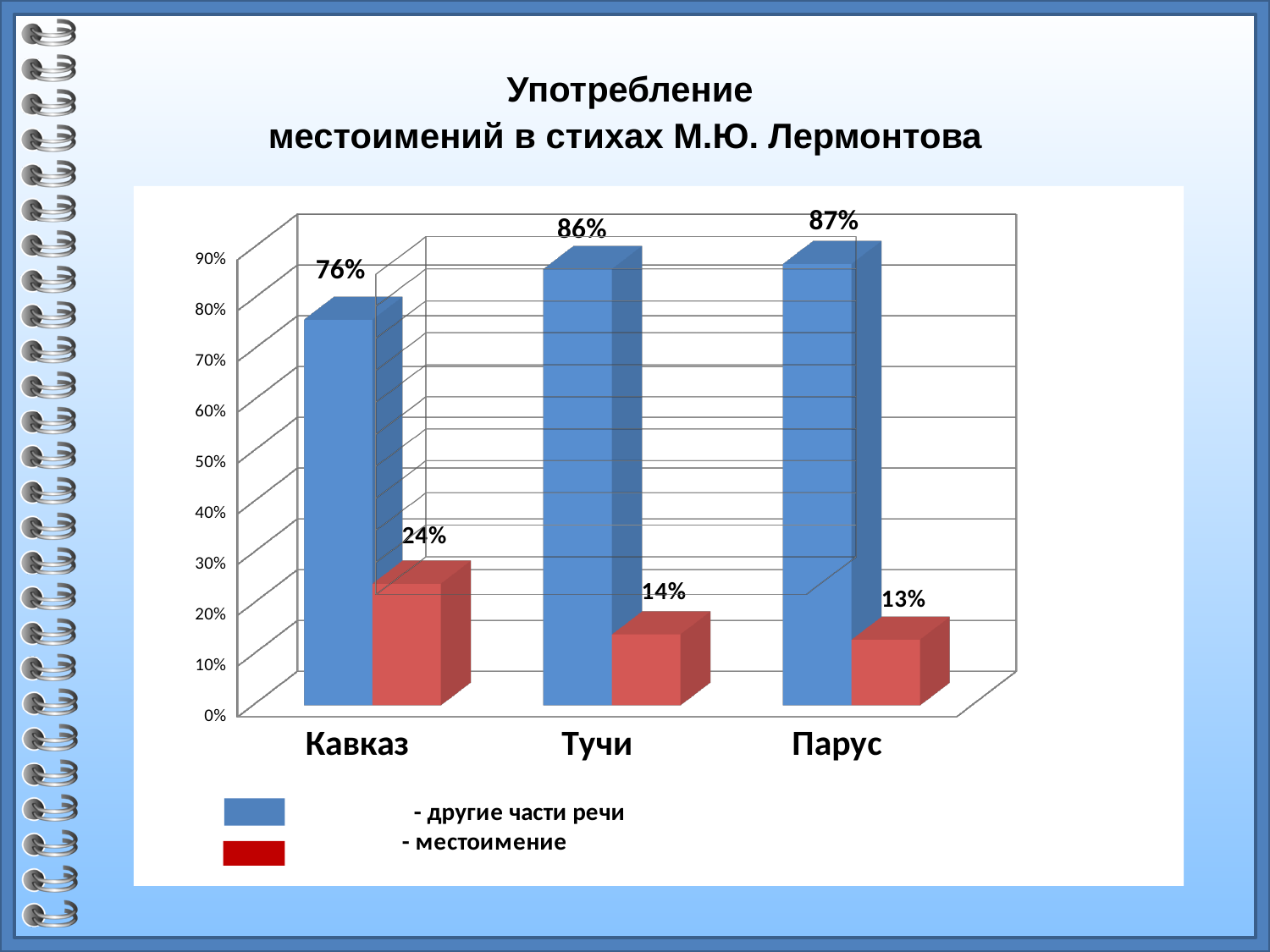
How many poems (categories) are shown on the x axis? 3 Which poem has the lowest value for 'местоимение'? Парус What is the value for 'местоимение' in 'Парус'? 13% What kind of chart is shown on the slide? bar chart Which colour represents 'местоимение' in the legend? red How many series does the legend list? 2 Do the 'местоимение' values rise or fall from 'Кавказ' to 'Парус'? fall What is the value for 'другие части речи' in 'Кавказ'? 76% What is the difference between the 'местоимение' values for 'Кавказ' and 'Тучи'? 10% What is the value for 'местоимение' in 'Тучи'? 14% Which poem has the highest value for 'другие части речи'? Парус Which is larger: the 'другие части речи' value for 'Кавказ' or for 'Тучи'? Тучи